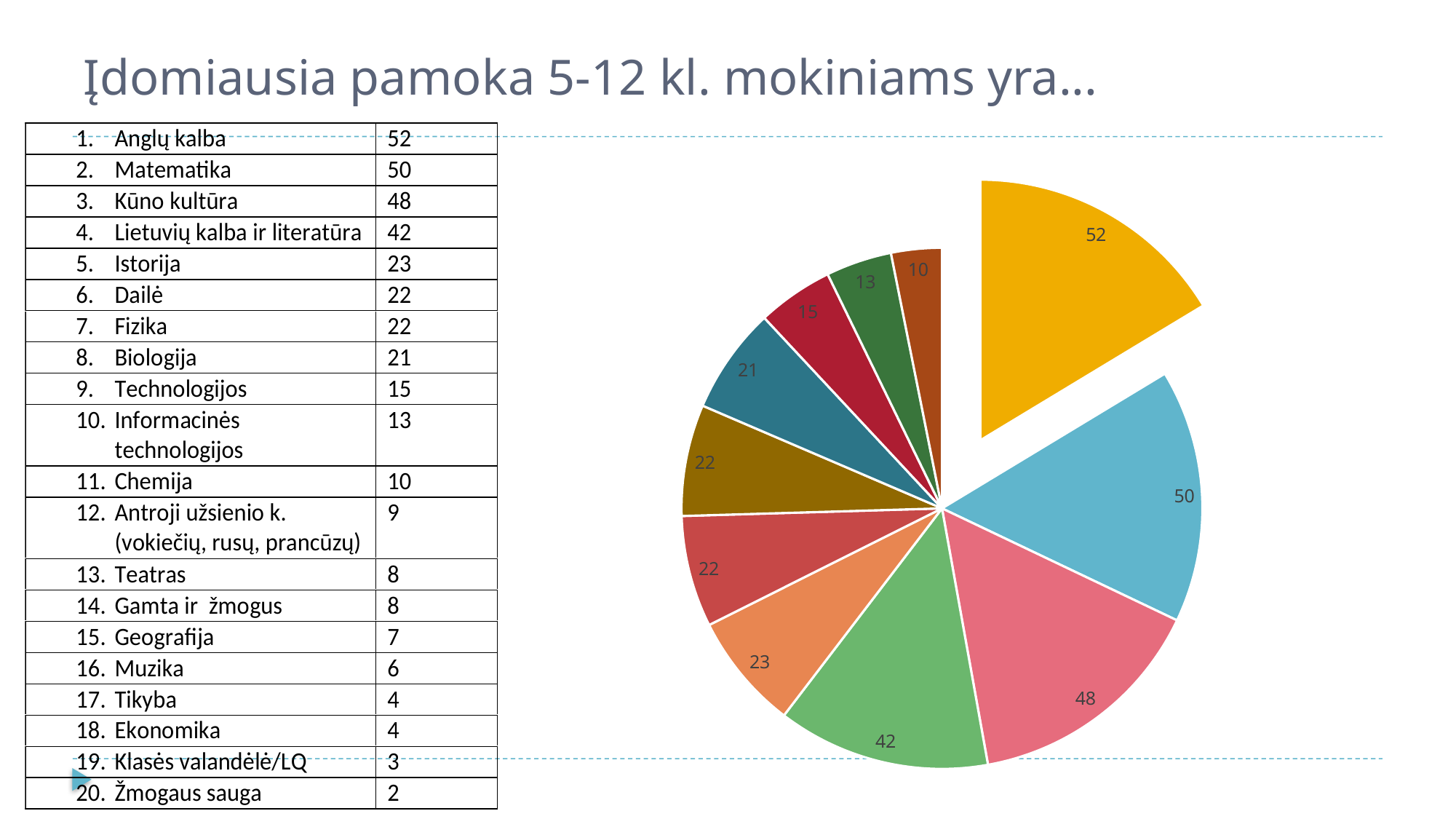
How many slices does the pie chart have? 11 What is the value of the yellow slice that is pulled out from the pie? 52 What is the value of the smallest slice in the pie chart? 10 What is the difference between the largest slice (52) and the smallest slice (10)? 42 Which slice is separated (exploded) from the rest of the pie? the yellow slice labelled 52 What kind of chart is shown on the slide? pie chart According to the table on the slide, which subject corresponds to the largest pie slice (52)? Anglų kalba What is the value of the light blue slice in the pie chart? 50 Which is larger, the orange slice labelled 23 or the teal slice labelled 21? 23 What is the value of the largest slice in the pie chart? 52 What is the difference between the slice labelled 48 and the slice labelled 42? 6 What is the difference between the largest slice (52) and the second largest slice (50)? 2